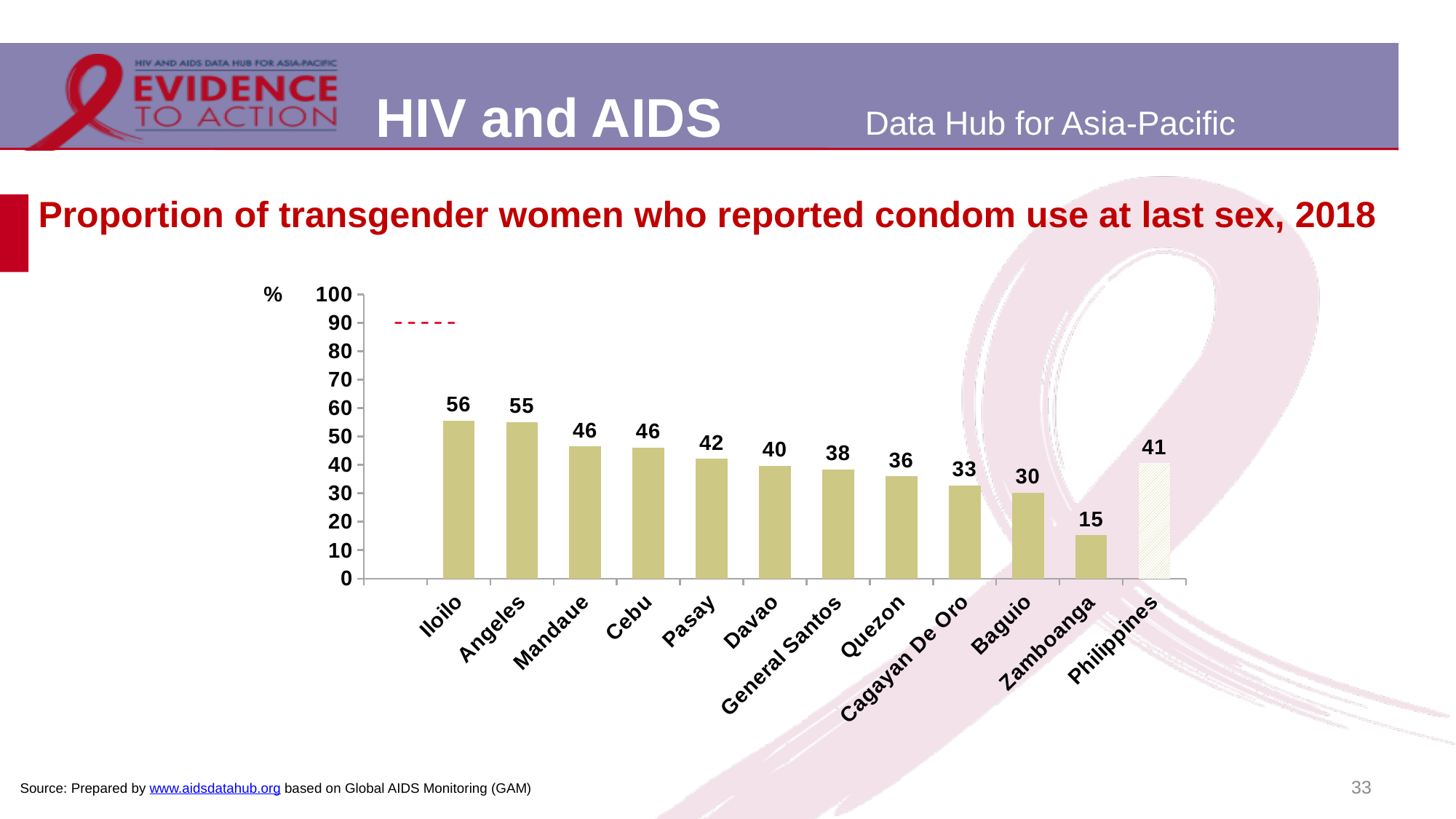
Which city has the highest proportion? Iloilo What is the value for Iloilo? 56 How many categories are shown on the x axis? 12 What is the value for Cagayan De Oro? 33 What kind of chart is shown on the slide? bar chart Which category has the lowest value? Zamboanga What is the difference between the values for Iloilo and Zamboanga? 41 What is the value for Zamboanga? 15 Which is larger, the value for Pasay or the value for Davao? Pasay What is the value for Philippines? 41 What is the title of the chart? Proportion of transgender women who reported condom use at last sex, 2018 Is the value for Baguio greater or less than 40? less